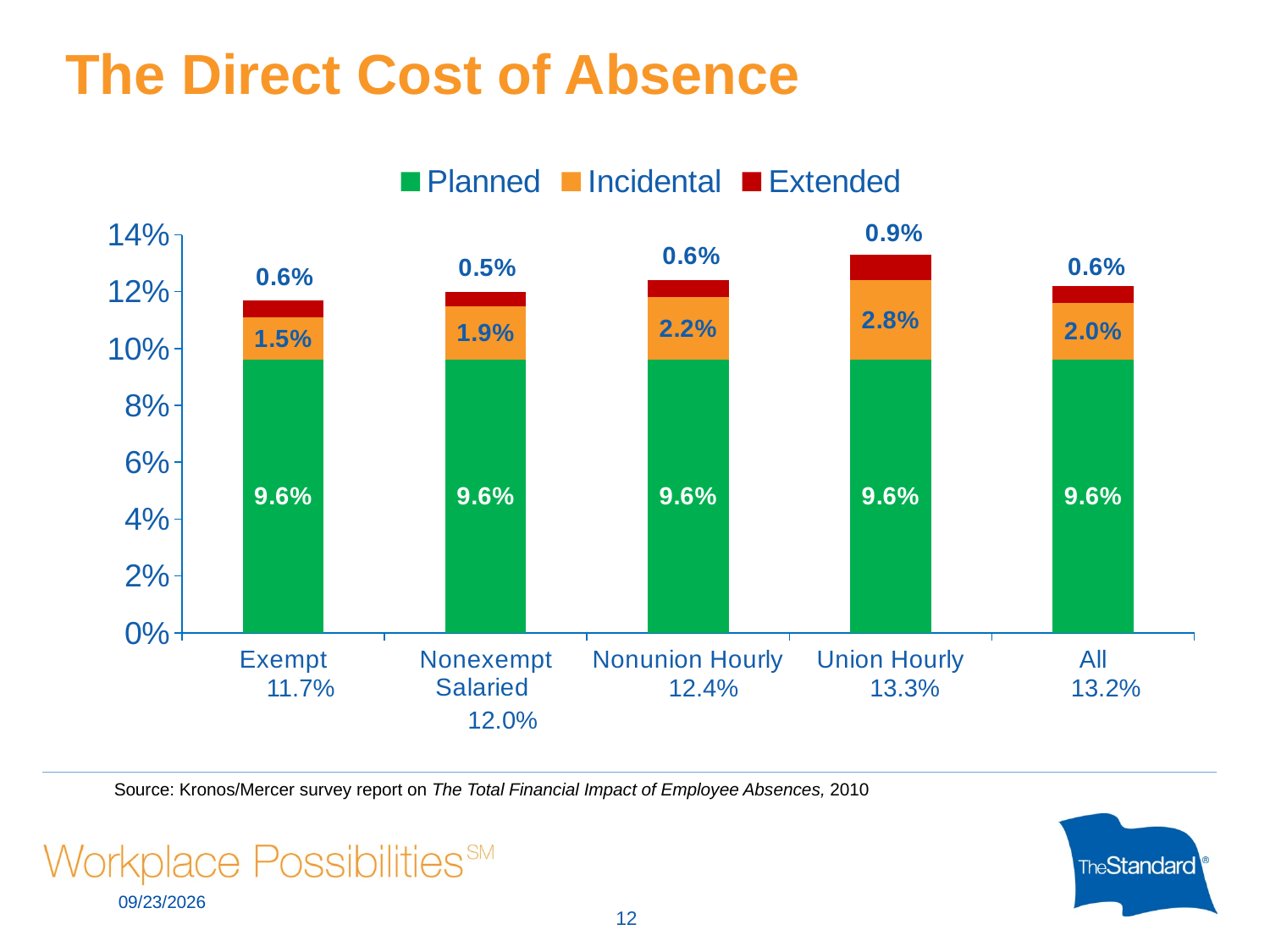
What is the total of the stacked bar for Union Hourly? 13.3% How many categories are shown on the x axis? 5 Which is larger, the Extended value for Union Hourly or for Nonunion Hourly? Union Hourly Which category has the lowest Incidental value? Exempt What is the Planned value for Exempt? 9.6% What is the difference between the Incidental values for Union Hourly and Exempt? 1.3% What is the Incidental value for Union Hourly? 2.8% What is the total of the stacked bar for All? 12.2% What is the Extended value for Nonexempt Salaried? 0.5% How many series does the legend list? 3 What kind of chart is shown on the slide? Stacked bar chart Which category has the highest Incidental value? Union Hourly